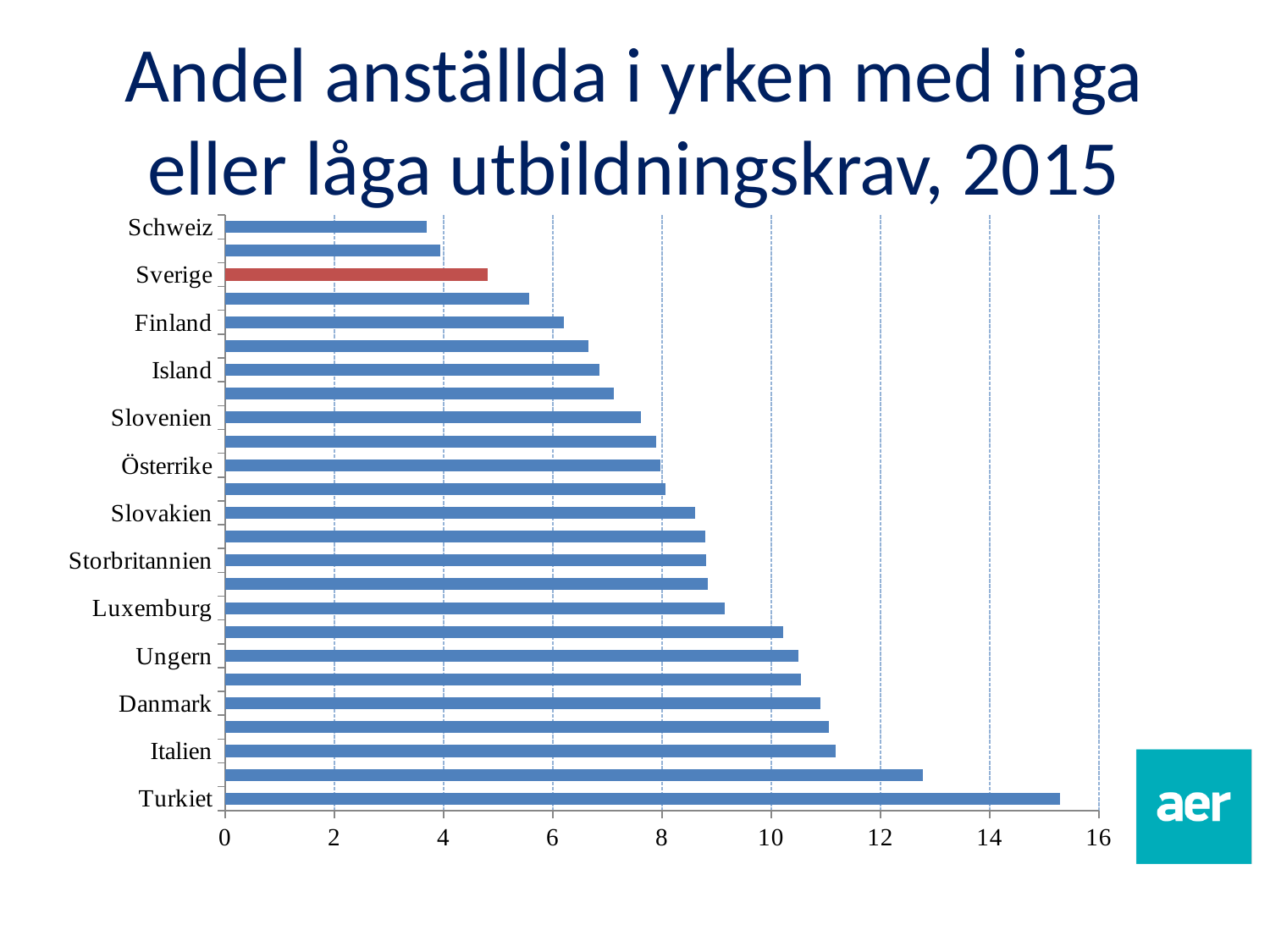
Is the value for Ungern greater or less than 10? greater Which has the larger value, Danmark or Sverige? Danmark Is the value for Schweiz greater or less than 4? less What kind of chart is shown on the slide? bar chart Is the value for Turkiet greater or less than 14? greater Which country has the lowest value in the chart? Schweiz Which bar is highlighted in a different colour (red) from the others? Sverige Which country has the highest value in the chart? Turkiet What is the title of the chart? Andel anställda i yrken med inga eller låga utbildningskrav, 2015